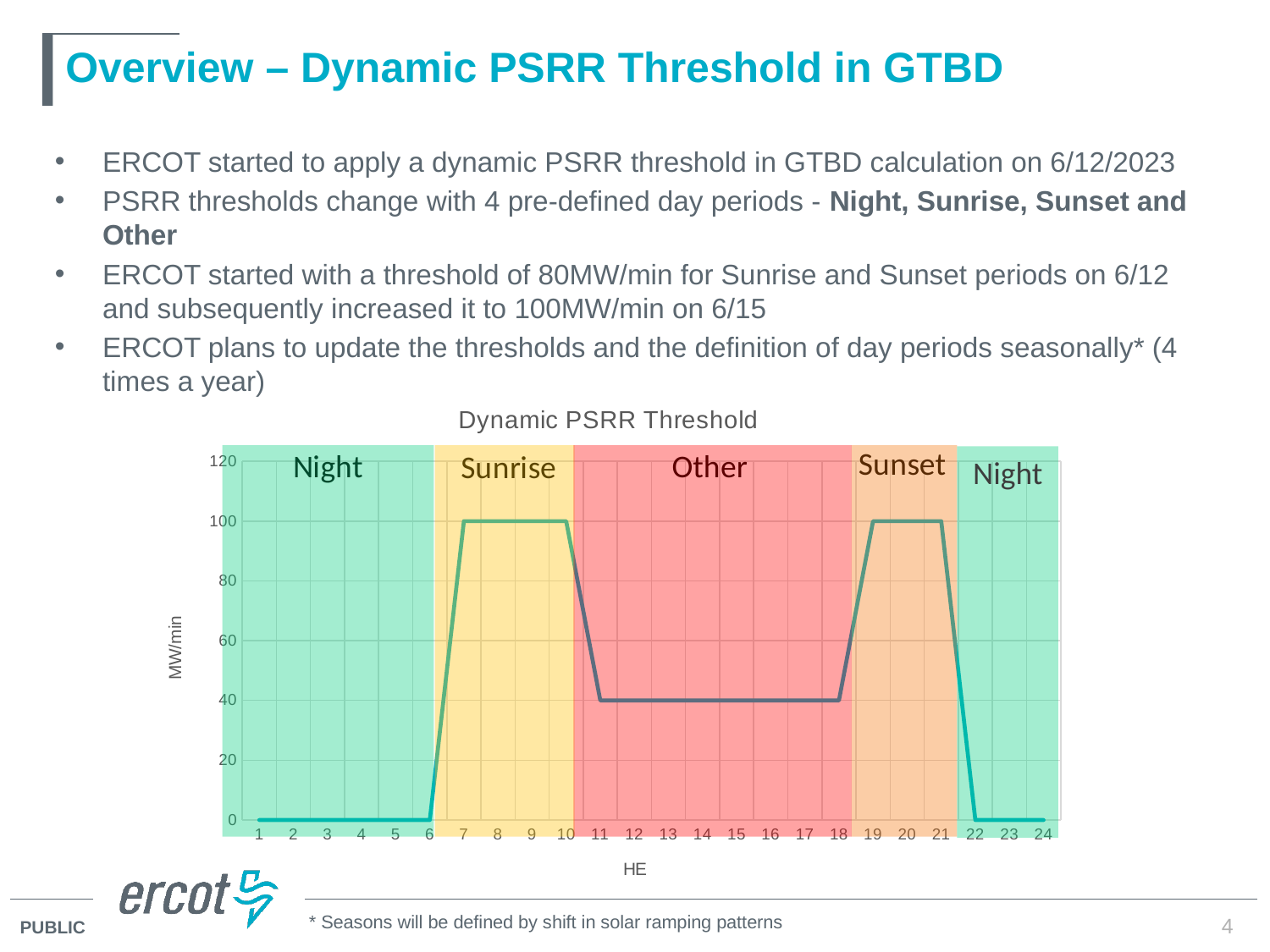
Which is larger, the value at HE 9 or the value at HE 12? HE 9 What is the difference between the value at HE 7 and the value at HE 11? 60 What is the value of the line at HE 3? 0 How many hour-ending (HE) points are shown on the x axis? 24 What kind of chart is shown on the slide? line chart What is the value of the line at HE 14? 40 What is the title of the chart on the slide? Dynamic PSRR Threshold Is the value at HE 15 greater or less than 60? less Does the line rise or fall between HE 10 and HE 11? fall What is the label of the y axis of the chart? MW/min What is the value of the line at HE 8? 100 What is the value of the line at HE 20? 100